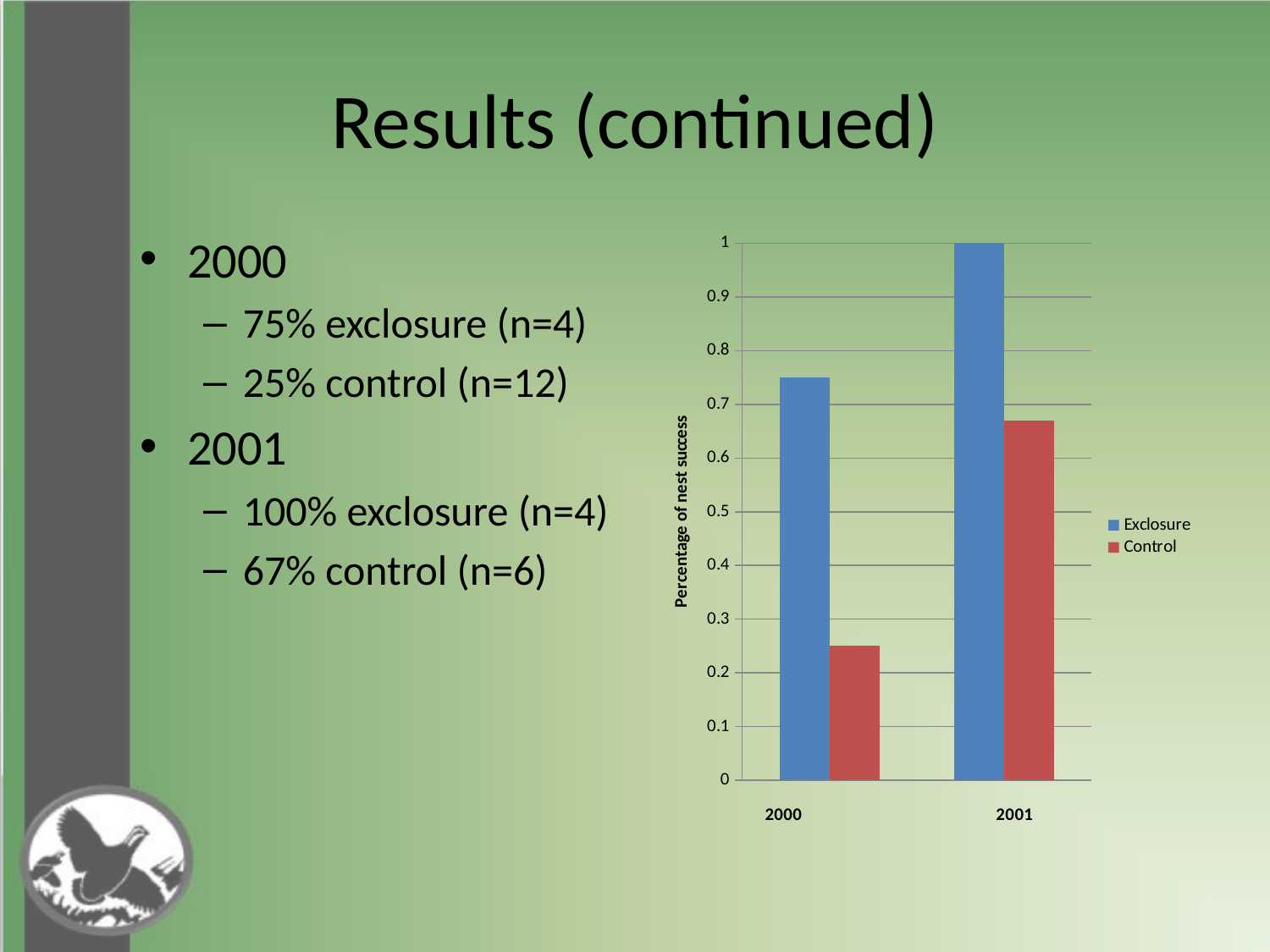
In 2000, which series has the larger value, Exclosure or Control? Exclosure What kind of chart is shown on the slide? bar chart What is the value of the Exclosure bar for 2001? 1 How many series does the chart's legend list? 2 Which bar in the chart is the tallest? Exclosure in 2001 Does the Control series rise or fall from 2000 to 2001? rise Is the value of the Exclosure bar for 2000 greater or less than 0.7? greater What is the title of the chart's vertical axis? Percentage of nest success How many categories are shown on the x axis of the chart? 2 Which bar in the chart is the shortest? Control in 2000 Is the value of the Control bar for 2000 greater or less than 0.3? less Is the value of the Control bar for 2001 greater or less than 0.6? greater